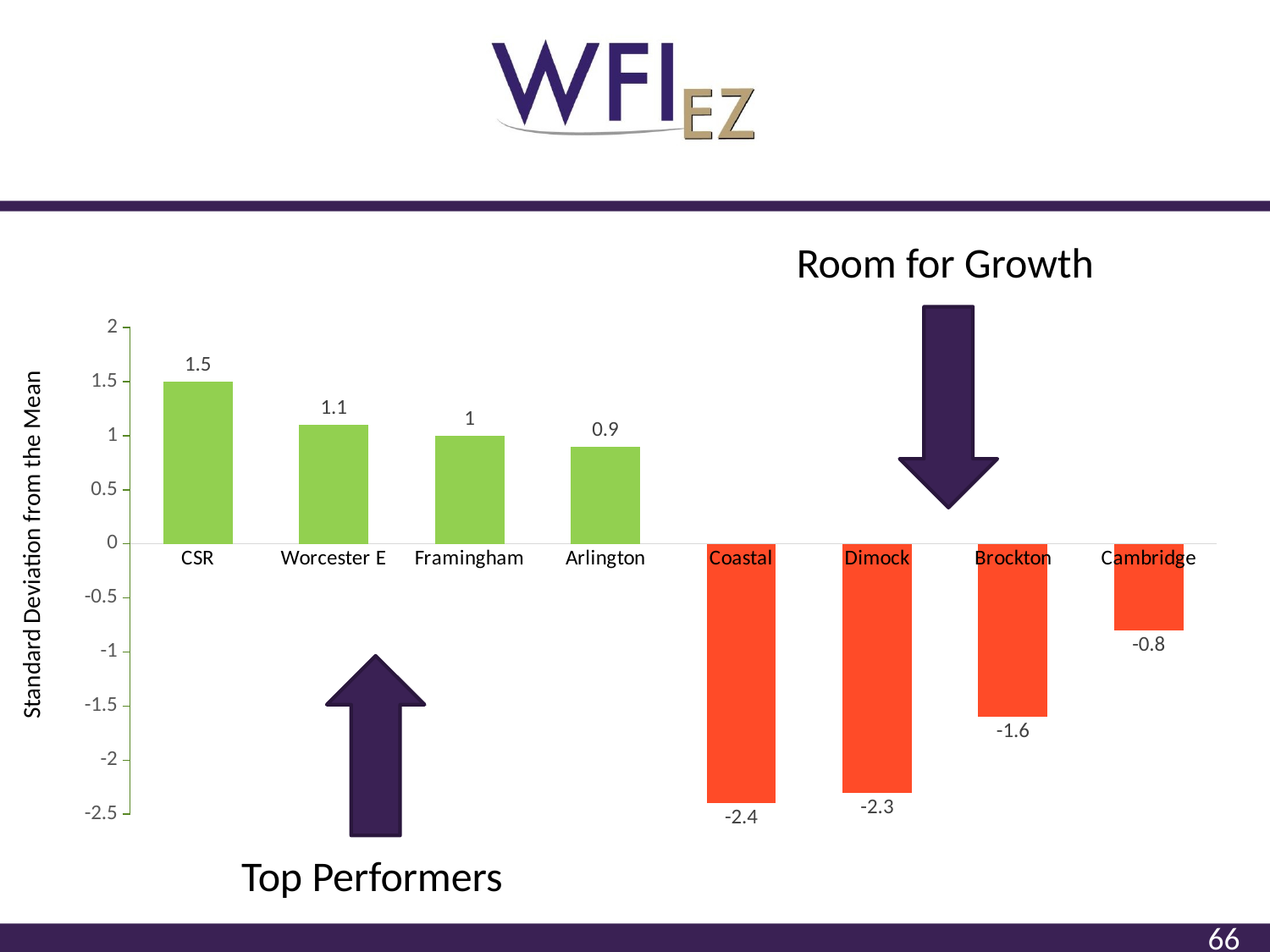
Which category has the highest value? CSR What is the difference between the values for Cambridge and Dimock? 1.5 What is the difference between the values for CSR and Arlington? 0.6 What kind of chart is shown on the slide? Bar chart What is the label of the vertical axis? Standard Deviation from the Mean Which is larger, the value for Framingham or the value for Arlington? Framingham What is the value for Coastal? -2.4 What is the value for Worcester E? 1.1 What is the value for Brockton? -1.6 Which category has the lowest value? Coastal What is the value for CSR? 1.5 How many categories are shown on the x axis? 8